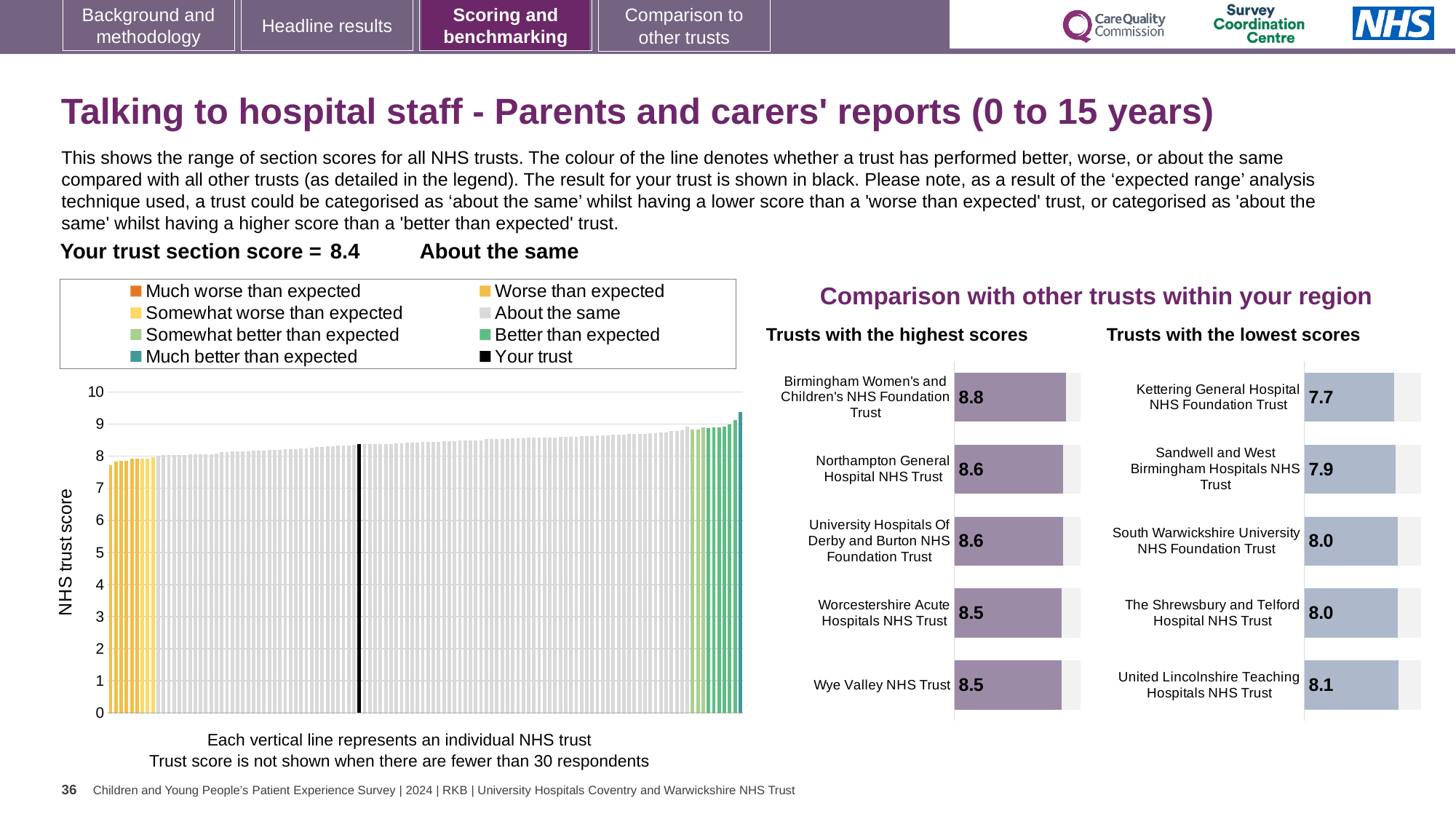
In the main chart on the left showing the range of section scores, what is your trust's section score? 8.4 In the 'Trusts with the highest scores' chart, what is the score for Birmingham Women's and Children's NHS Foundation Trust? 8.8 In the 'Trusts with the lowest scores' chart, which has the larger score: Sandwell and West Birmingham Hospitals NHS Trust or Kettering General Hospital NHS Foundation Trust? Sandwell and West Birmingham Hospitals NHS Trust In the 'Trusts with the lowest scores' chart, what is the difference between the scores of United Lincolnshire Teaching Hospitals NHS Trust and Kettering General Hospital NHS Foundation Trust? 0.4 In the 'Trusts with the lowest scores' chart, which trust has the highest score? United Lincolnshire Teaching Hospitals NHS Trust How many entries does the legend of the main chart on the left list? 8 In the main chart on the left, is the value for your trust (the black line) greater or less than 8? greater In the 'Trusts with the highest scores' chart, what is the difference between the scores of Birmingham Women's and Children's NHS Foundation Trust and Wye Valley NHS Trust? 0.3 In the 'Trusts with the highest scores' chart, how many trusts are shown? 5 In the 'Trusts with the highest scores' chart, which trust has the highest score? Birmingham Women's and Children's NHS Foundation Trust In the 'Trusts with the lowest scores' chart, what is the score for Kettering General Hospital NHS Foundation Trust? 7.7 In the 'Trusts with the lowest scores' chart, which trust has the lowest score? Kettering General Hospital NHS Foundation Trust